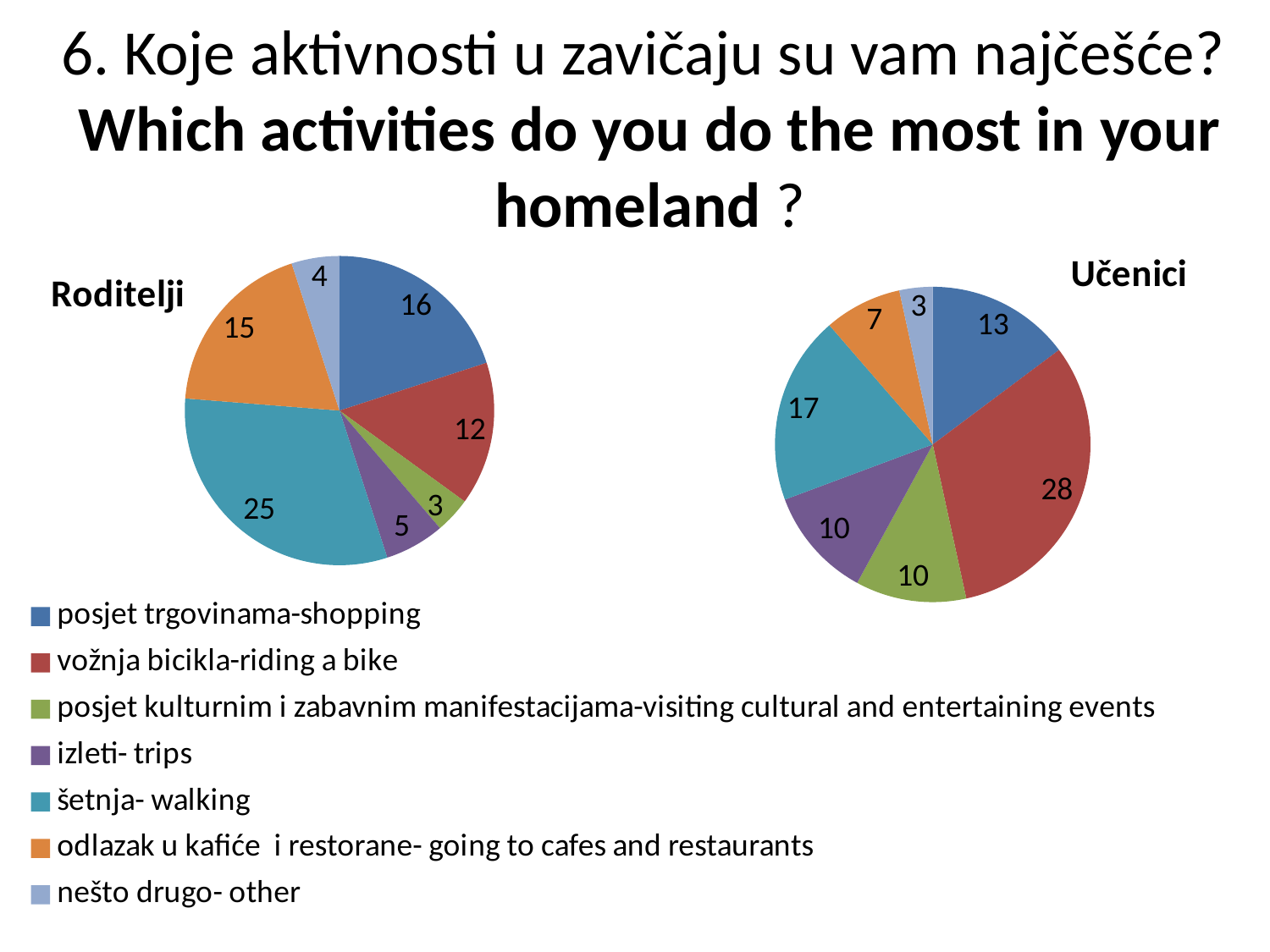
In the Učenici pie chart, which category has the smallest slice? nešto drugo- other In the Učenici pie chart, what is the value for nešto drugo- other? 3 Which is larger: the value for posjet trgovinama-shopping in the Roditelji chart or in the Učenici chart? Roditelji In the Roditelji pie chart, which category has the largest slice? šetnja- walking In the Učenici pie chart, what is the value for vožnja bicikla-riding a bike? 28 In the Roditelji pie chart, what is the value for odlazak u kafiće i restorane- going to cafes and restaurants? 15 What type of charts are shown on the slide? Pie charts What is the total of all values in the Roditelji pie chart? 80 What is the difference between the value for vožnja bicikla-riding a bike in the Učenici chart and in the Roditelji chart? 16 In the Roditelji pie chart, which category has the smallest slice? posjet kulturnim i zabavnim manifestacijama-visiting cultural and entertaining events How many categories does the legend list? 7 In the Roditelji pie chart, what is the value for šetnja- walking? 25